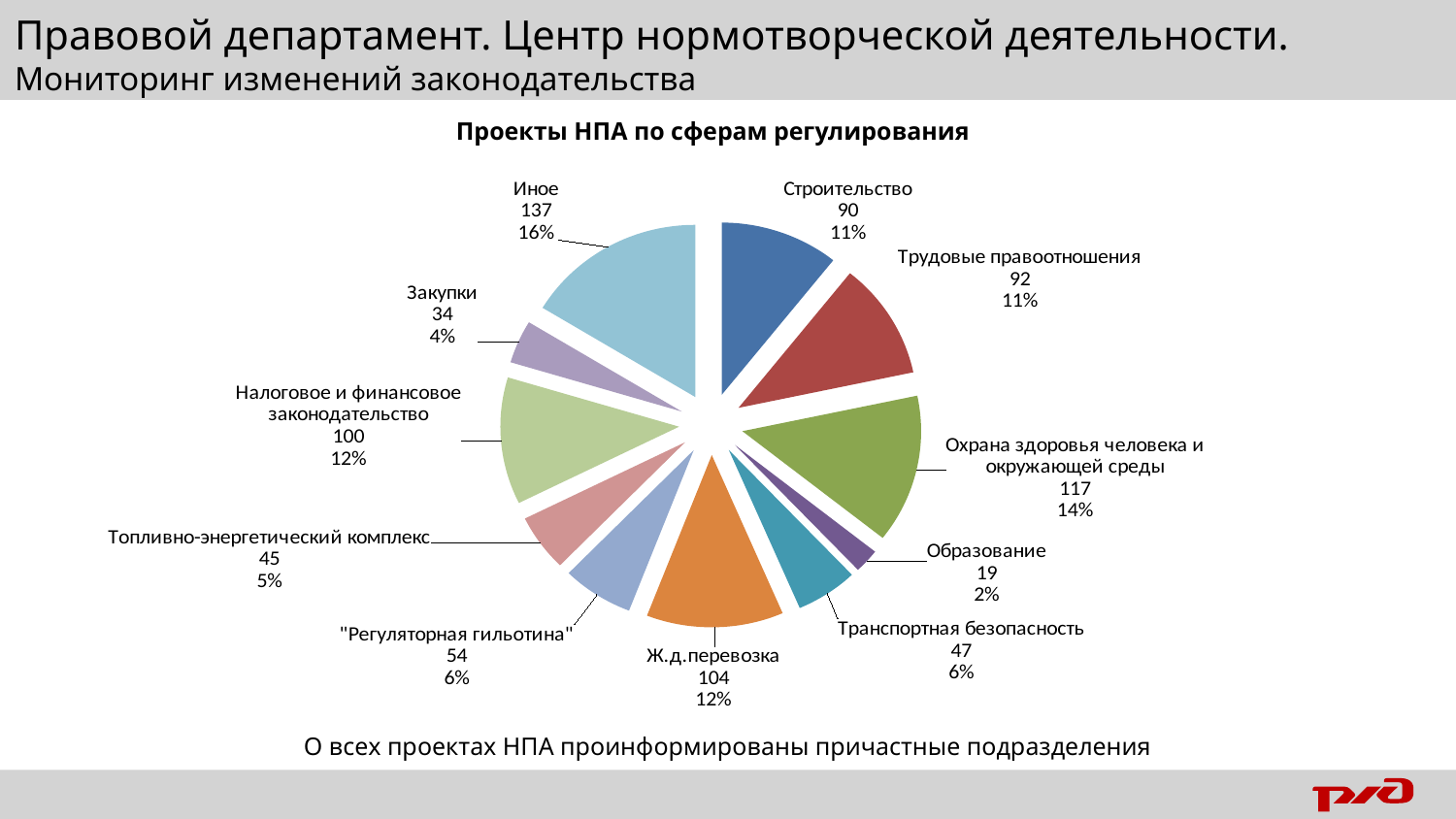
What kind of chart is shown on the slide? Pie chart What is the title of the chart? Проекты НПА по сферам регулирования What is the difference between the values for Иное and Образование? 118 What share of the pie does Транспортная безопасность represent? 6% What share of the pie does Ж.д.перевозка represent? 12% What is the value for Топливно-энергетический комплекс? 45 Which category has the smallest value? Образование How many categories (slices) does the pie chart have? 11 Which category has the largest value? Иное What is the value for Охрана здоровья человека и окружающей среды? 117 Which is larger: Налоговое и финансовое законодательство or Закупки? Налоговое и финансовое законодательство What is the value for Иное? 137